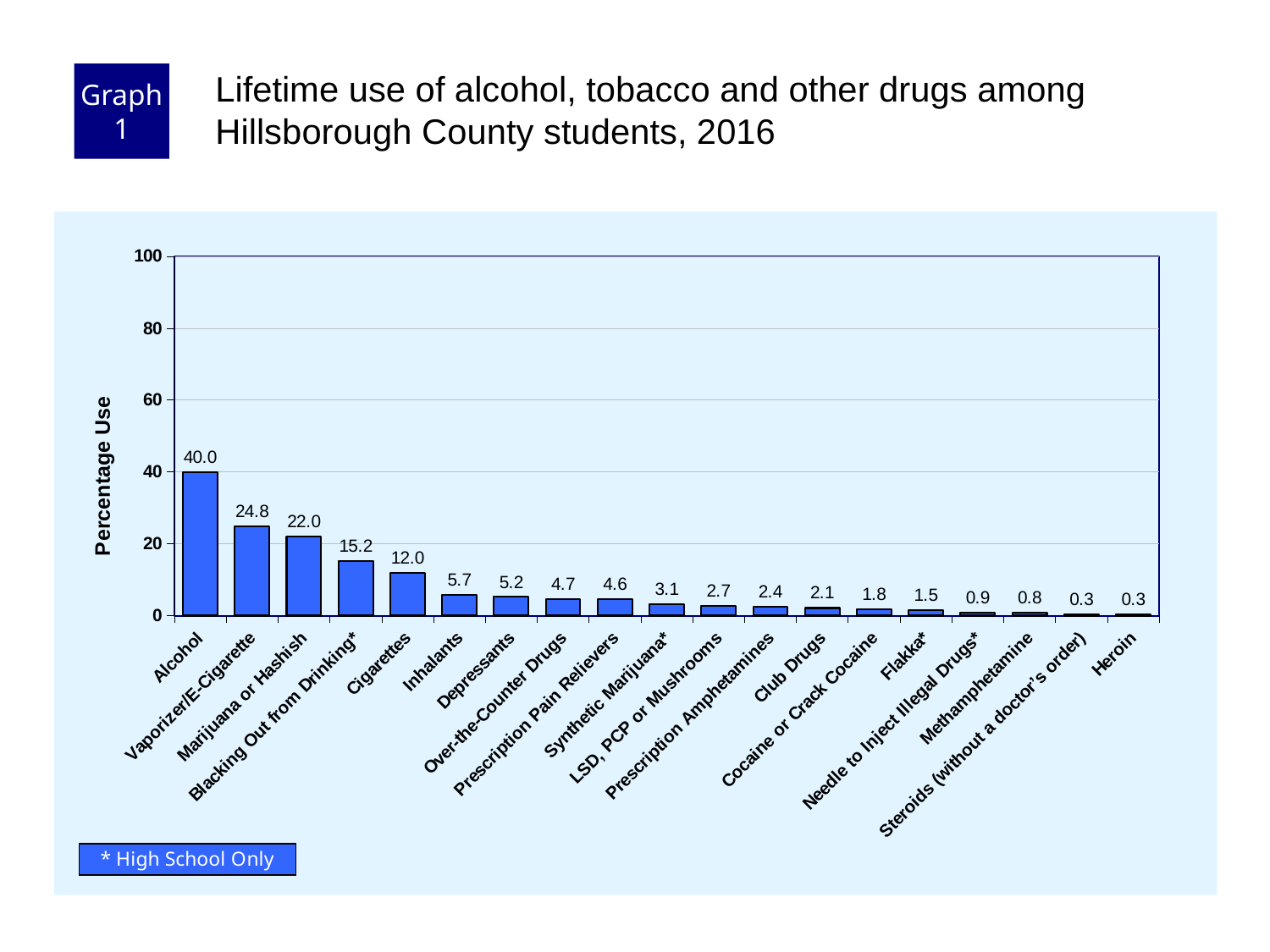
How many categories are shown on the x axis? 19 What kind of chart is shown on the slide? Bar chart Which category has the highest percentage use? Alcohol Is the value for Vaporizer/E-Cigarette greater or less than 20? greater What is the percentage use for Vaporizer/E-Cigarette? 24.8 What is the difference in percentage use between Alcohol and Marijuana or Hashish? 18.0 What is the difference in percentage use between Inhalants and Depressants? 0.5 Which has a higher percentage use, Blacking Out from Drinking* or Cigarettes? Blacking Out from Drinking* What is the percentage use for Alcohol? 40.0 What is the percentage use for Cigarettes? 12.0 What is the percentage use for Club Drugs? 2.1 What is the label of the y axis? Percentage Use